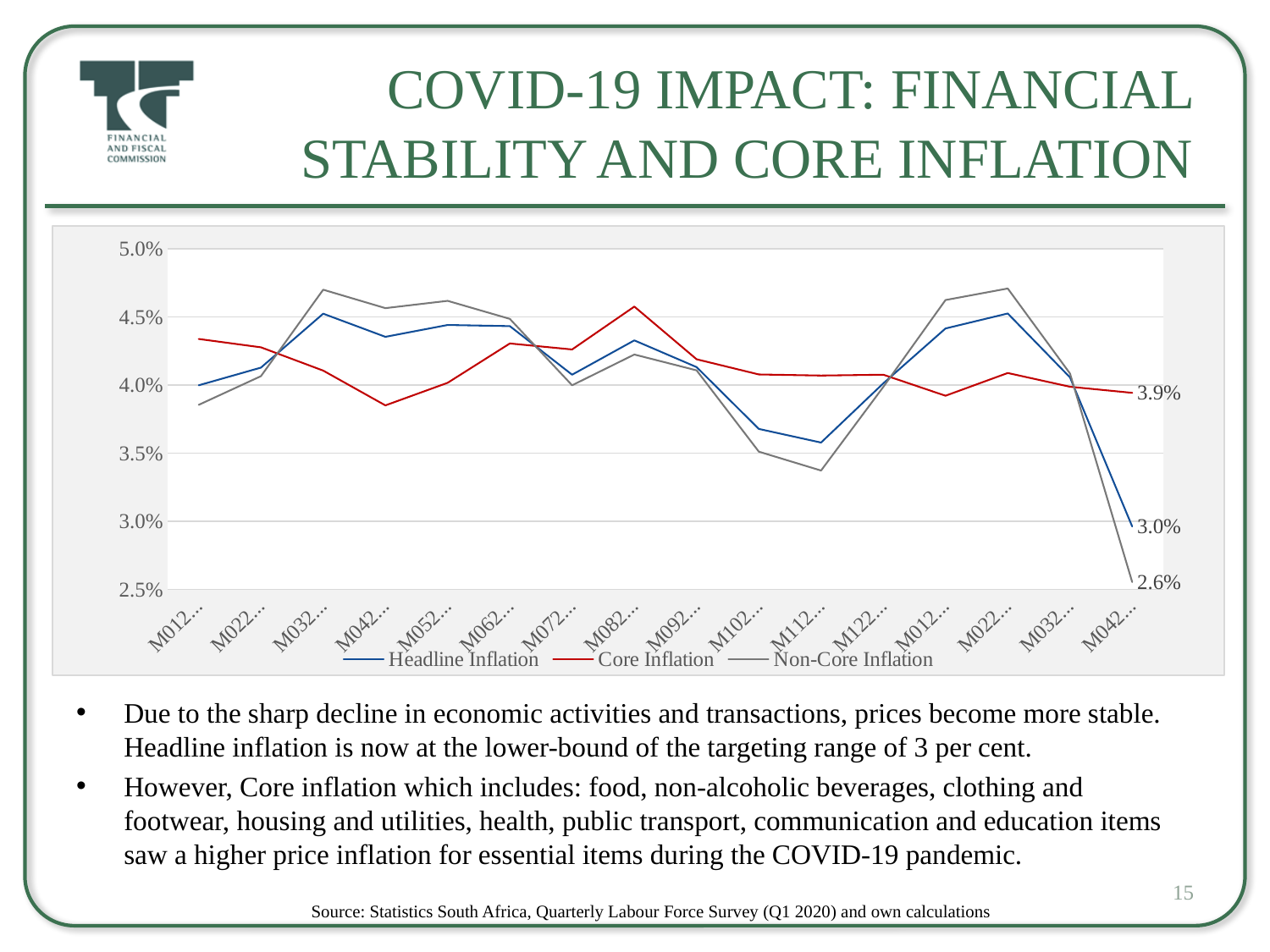
What is the value of Non-Core Inflation at the last data point on the chart? 2.6% Which series has the highest value at the last data point on the chart? Core Inflation What is the value of Core Inflation at the last data point on the chart? 3.9% How many series does the chart legend list? 3 Which colour is used for the Core Inflation line in the chart? Red Which series has the lowest value at the last data point on the chart? Non-Core Inflation Is the value of Headline Inflation at the first data point greater or less than 4.5%? less What is the difference between Core Inflation and Headline Inflation at the last data point? 0.9% What kind of chart is shown on the slide? Line chart At the last data point, which is larger: Headline Inflation or Non-Core Inflation? Headline Inflation Does Headline Inflation rise or fall between the second-to-last and the last data point? fall What is the value of Headline Inflation at the last data point on the chart? 3.0%